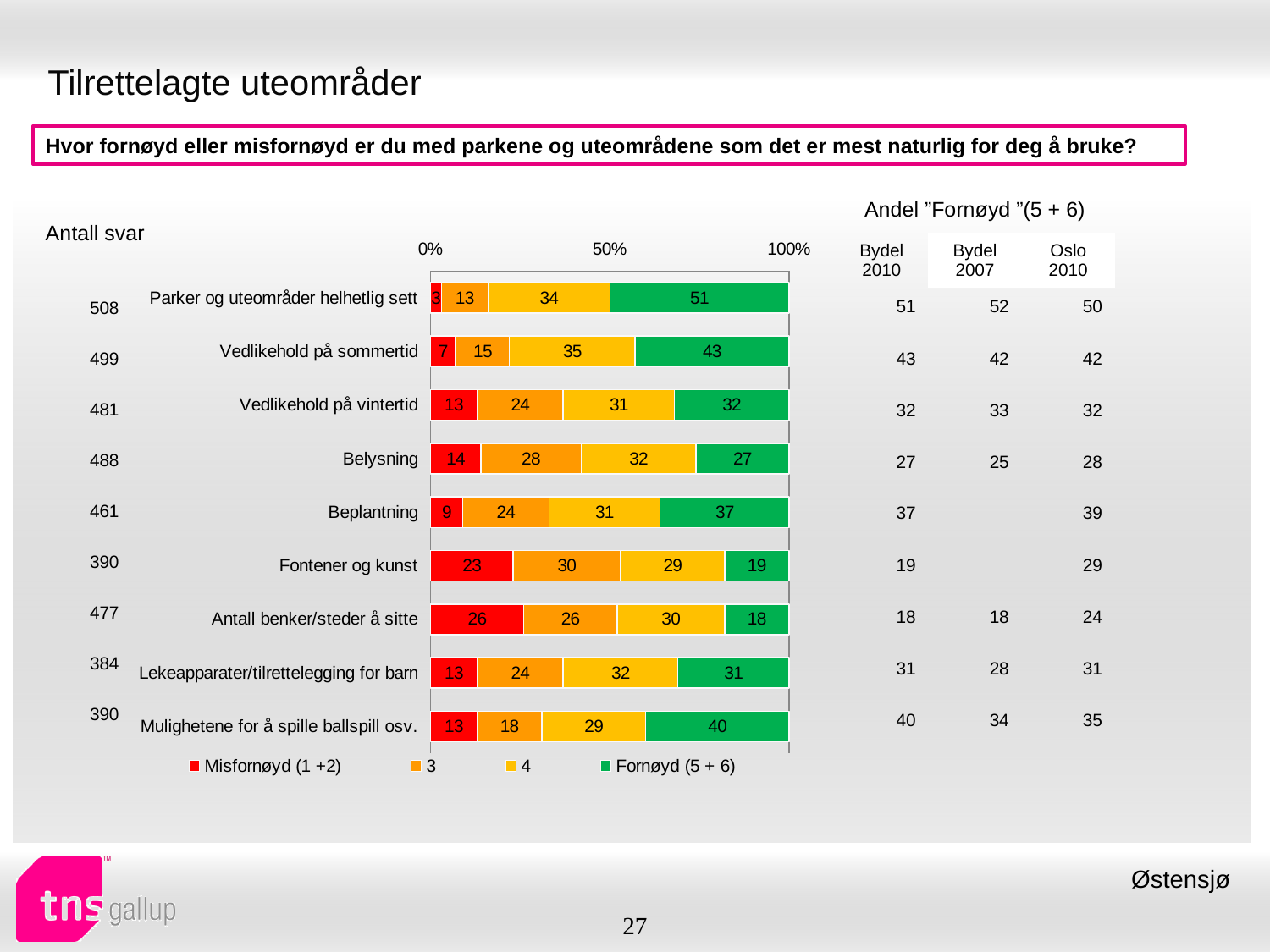
What is the value of series 4 for Mulighetene for å spille ballspill osv.? 29 How many series does the chart legend list? 4 Which category has the highest Fornøyd (5 + 6) value? Parker og uteområder helhetlig sett How many categories are plotted in the chart? 9 What is the total of the stacked bar for Vedlikehold på sommertid? 100 What is the Misfornøyd (1 +2) value for Antall benker/steder å sitte? 26 Which category has the lowest Fornøyd (5 + 6) value? Antall benker/steder å sitte Which has a larger Misfornøyd (1 +2) value, Fontener og kunst or Beplantning? Fontener og kunst What type of chart is shown on the slide? Stacked bar chart What is the Fornøyd (5 + 6) value for Belysning? 27 Which series is shown in green in the chart legend? Fornøyd (5 + 6) What is the difference between the Fornøyd (5 + 6) values for Vedlikehold på sommertid and Vedlikehold på vintertid? 11